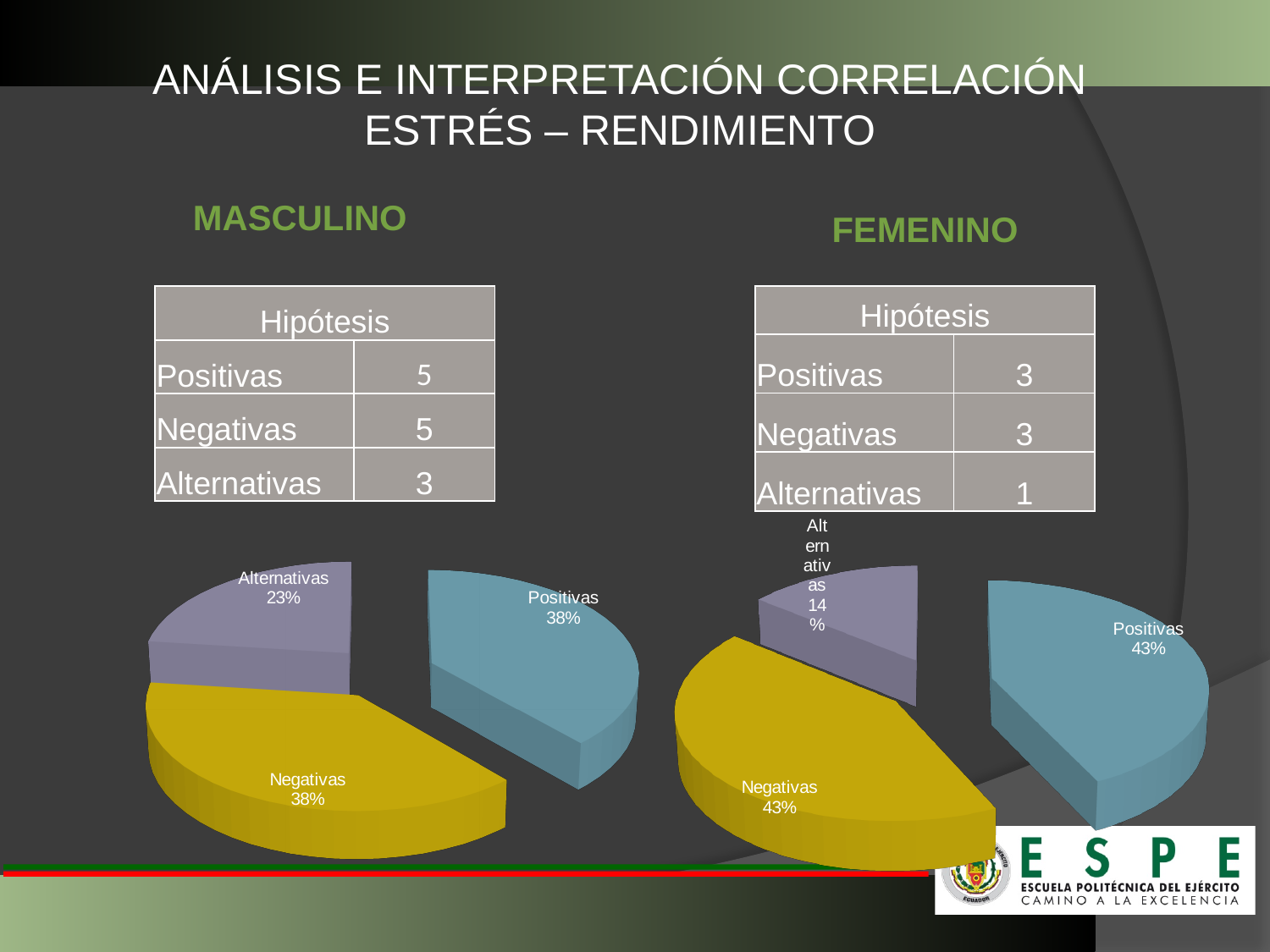
In the FEMENINO pie chart, which is larger, the Positivas slice or the Alternativas slice? Positivas In the FEMENINO pie chart, what share does the Negativas slice have? 43% In the MASCULINO pie chart, what share does the Positivas slice have? 38% In the MASCULINO pie chart, which slice is the smallest? Alternativas In the FEMENINO pie chart, which slice is the smallest? Alternativas In the MASCULINO pie chart, what is the difference in percentage points between the Negativas slice and the Alternativas slice? 15 How many slices does the MASCULINO pie chart have? 3 In the FEMENINO pie chart, what is the difference in percentage points between the Positivas slice and the Alternativas slice? 29 In the MASCULINO pie chart, what share does the Alternativas slice have? 23% What kind of chart is used under the FEMENINO heading? Pie chart In the MASCULINO pie chart, what colour is the Negativas slice? Yellow